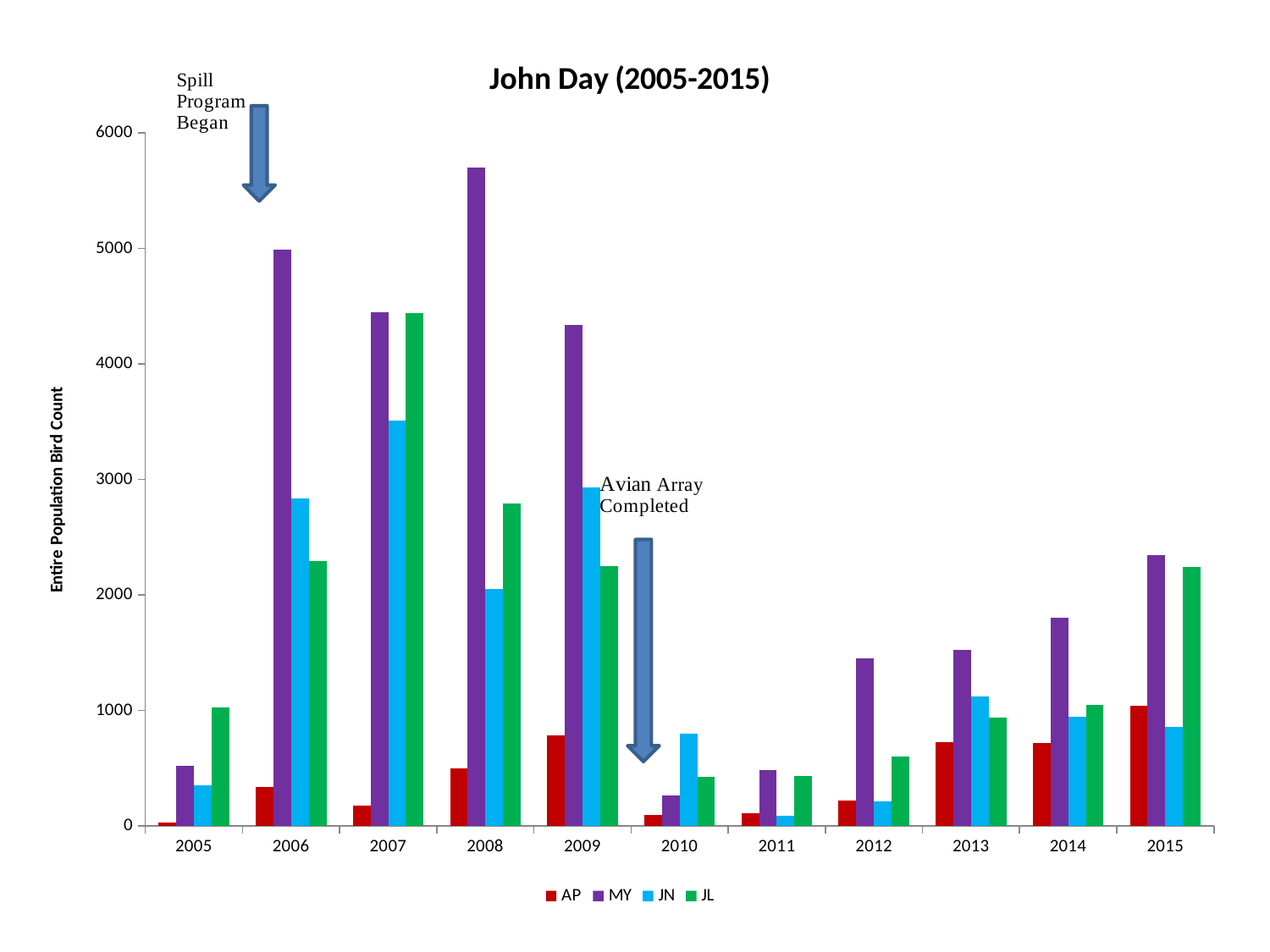
Is the MY value for 2012 greater or less than 1000? greater Is the JL value for 2006 greater or less than 2000? greater In 2006, which is larger, the MY value or the JN value? MY In 2010, which is larger, the JN value or the MY value? JN How many years are shown on the x axis? 11 Is the MY value for 2008 greater or less than 5000? greater Does the MY value rise or fall from 2010 to 2015? rise How many series does the legend list? 4 What is the title of the y axis? Entire Population Bird Count In which year is the MY bar the highest? 2008 What kind of chart is shown on the slide? bar chart